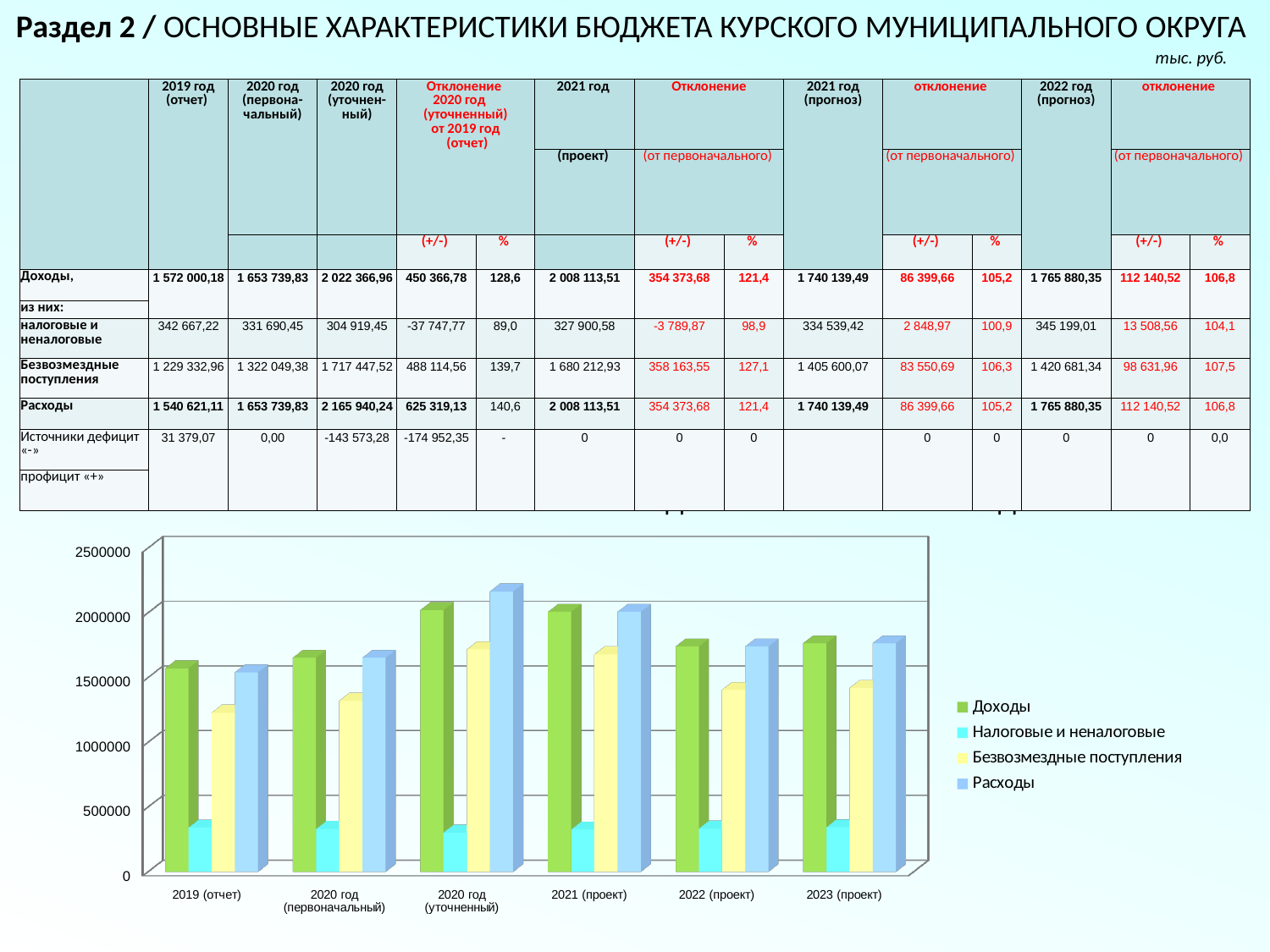
Which category has the highest value of Расходы? 2020 год (уточненный) Is the value of Расходы for 2021 (проект) greater or less than 1500000? greater Which series has the lowest value in every category of the chart? Налоговые и неналоговые Is the value of Доходы for 2020 год (уточненный) greater or less than 1500000? greater What kind of chart is shown at the bottom of the slide? bar chart Is the value of Налоговые и неналоговые for 2019 (отчет) greater or less than 500000? less Do the values of Доходы rise or fall from 2019 (отчет) to 2020 год (уточненный)? rise Which is larger: Безвозмездные поступления for 2020 год (уточненный) or for 2019 (отчет)? 2020 год (уточненный) What colour represents Доходы in the chart legend? green How many categories are shown along the x axis of the chart? 6 How many series does the chart legend list? 4